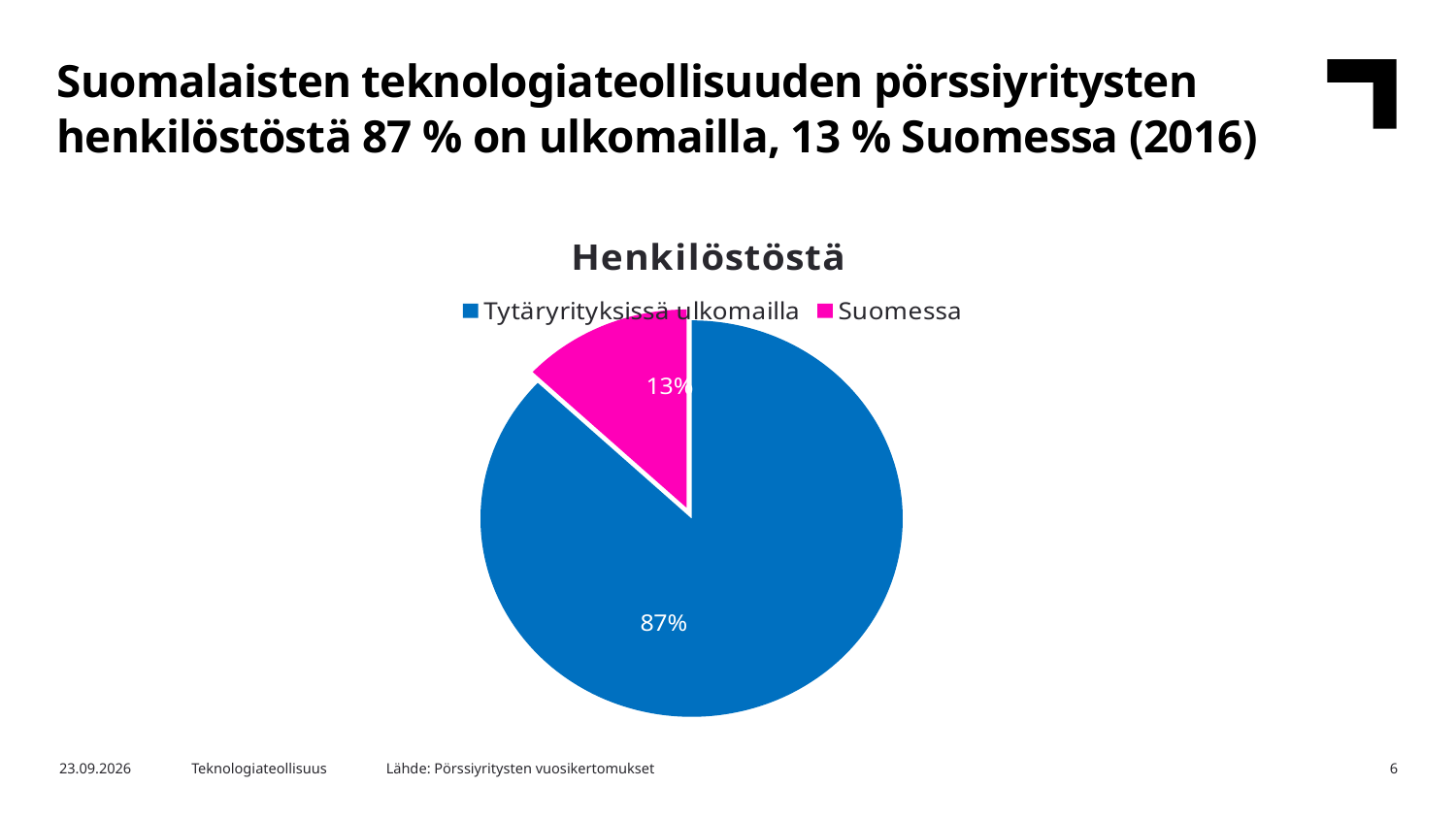
Which slice is the smallest in the pie chart? Suomessa What is the title of the chart? Henkilöstöstä What is the difference in percentage points between the 'Tytäryrityksissä ulkomailla' and 'Suomessa' slices? 74 percentage points What colour is the 'Suomessa' slice? Magenta (pink) What share of the pie does the 'Tytäryrityksissä ulkomailla' slice represent? 87% How many slices does the pie chart have? 2 What share of the pie does the 'Suomessa' slice represent? 13% Which slice is the largest in the pie chart? Tytäryrityksissä ulkomailla How many entries does the legend list? 2 What kind of chart is shown on the slide? Pie chart Which is larger, the 'Suomessa' slice or the 'Tytäryrityksissä ulkomailla' slice? Tytäryrityksissä ulkomailla